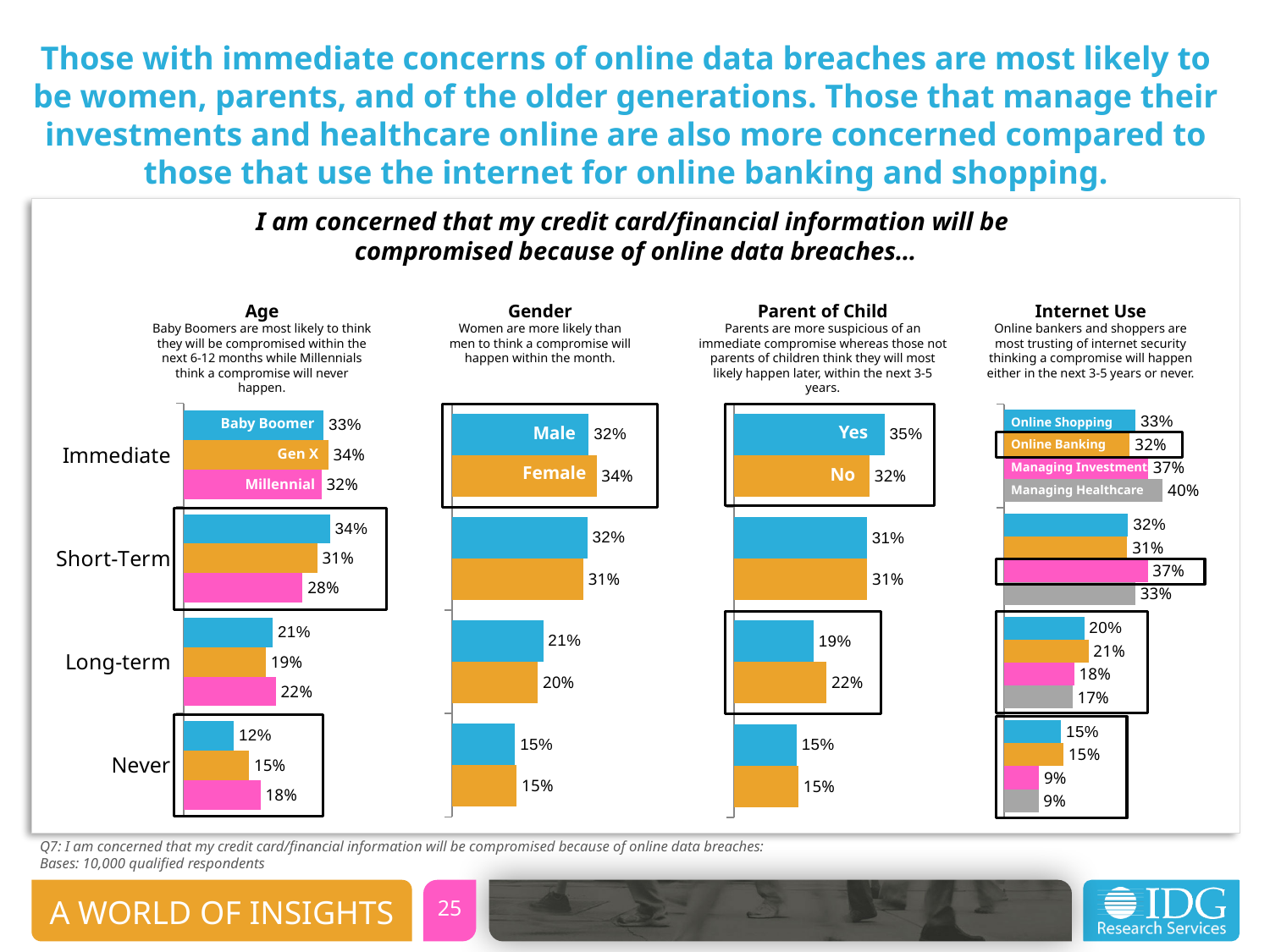
In the Age chart, what is the Millennial value for Never? 18% In the Parent of Child chart, what is the Yes value for Immediate? 35% In the Internet Use chart, which series has the highest Immediate value? Managing Healthcare In the Gender chart, what is the Female value for Immediate? 34% In the Gender chart, what is the difference between the Male and Female values for Immediate? 2% In the Age chart, what percentage of Baby Boomers fall in the Immediate category? 33% How many series does the Internet Use chart show? 4 In the Internet Use chart, what is the Managing Healthcare value for Never? 9% In the Parent of Child chart, which is larger for Long-term, Yes or No? No In the Internet Use chart, what is the Managing Investments value for Short-Term? 37% In the Age chart, which generation has the lowest Short-Term value? Millennial What type of chart is used for the Gender breakdown? Bar chart